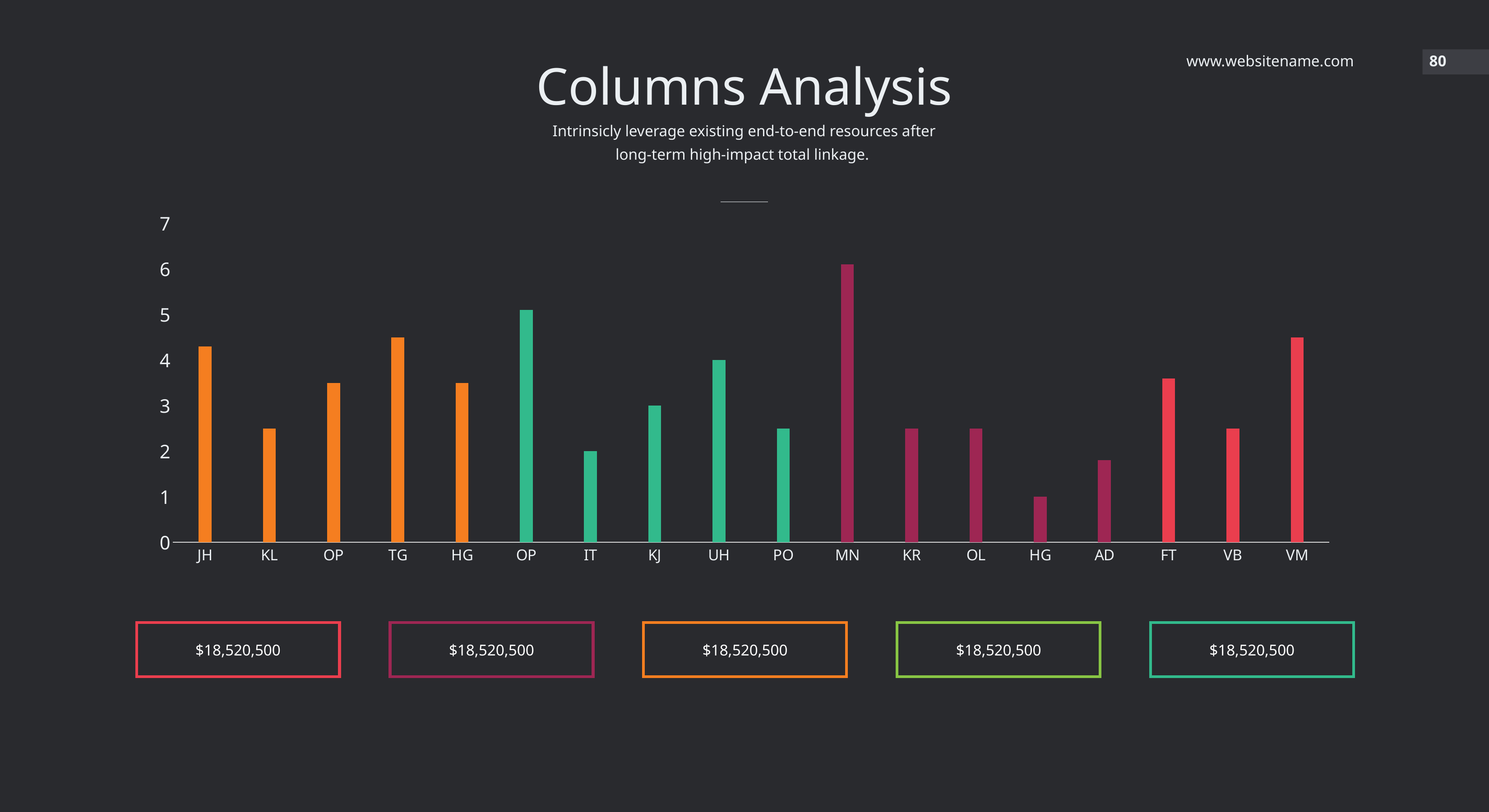
How many categories are plotted along the x axis of the chart? 18 Is the value for IT greater or less than 3? less What is the highest value shown on the y axis of the chart? 7 What kind of chart is shown on the slide? bar chart Which category has the lowest bar in the chart? HG What is the title of the chart on the slide? Columns Analysis Which category has the highest bar in the chart? MN Which has the larger value, TG or KL? TG Is the value for MN greater or less than 5? greater Which has the larger value, VM or IT? VM Is the value for JH greater or less than 4? greater